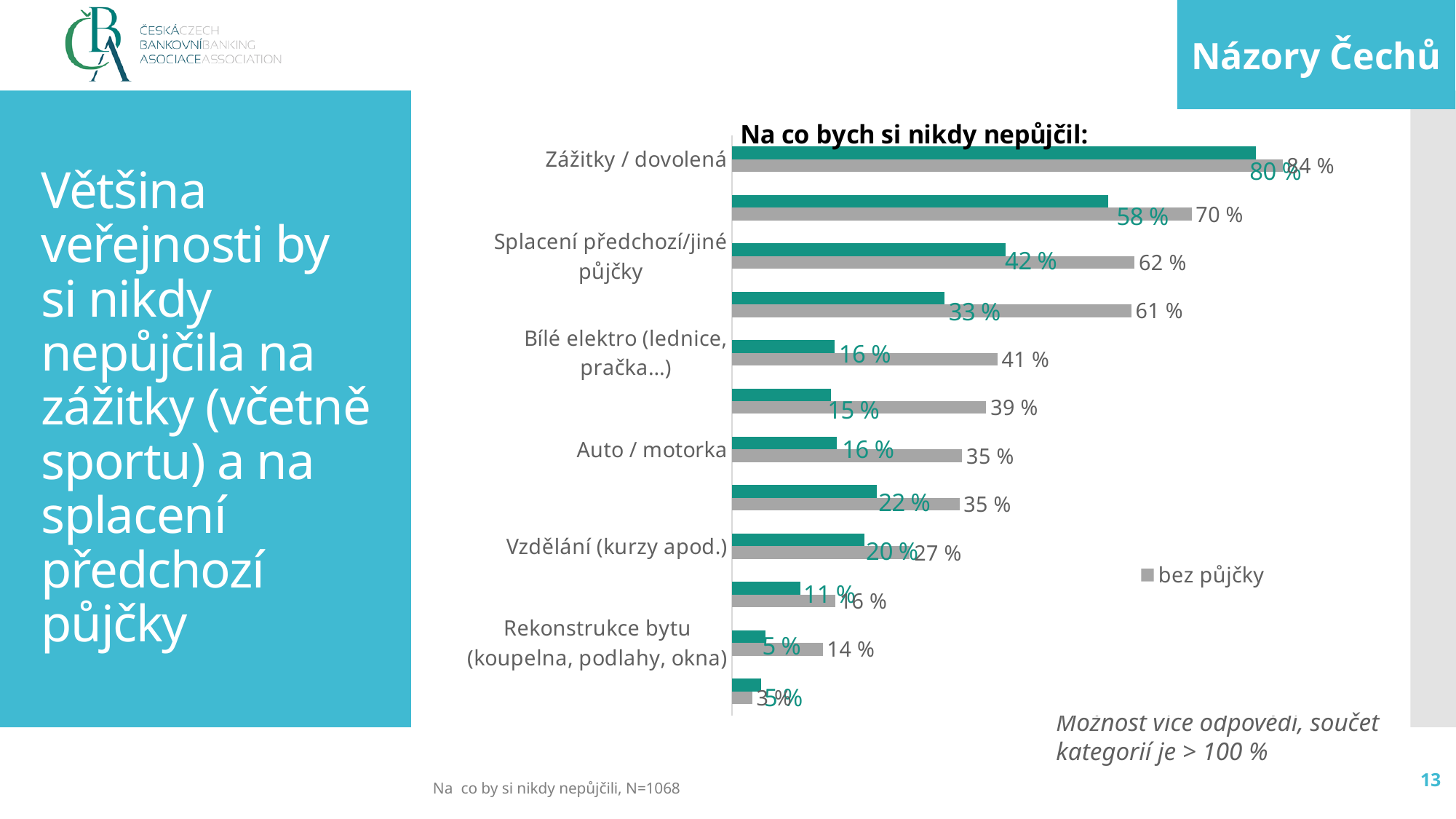
What is the title of the chart? Na co bych si nikdy nepůjčil: What colour are the 'bez půjčky' bars? Gray What is the 'bez půjčky' value for Bílé elektro (lednice, pračka…)? 41 % What kind of chart is shown on the slide? Bar chart Which labelled category has the highest 'bez půjčky' value? Zážitky / dovolená What is the 'bez půjčky' value for Splacení předchozí/jiné půjčky? 62 % What is the 'bez půjčky' value for Rekonstrukce bytu (koupelna, podlahy, okna)? 14 % Which has the larger 'bez půjčky' value: Bílé elektro (lednice, pračka…) or Auto / motorka? Bílé elektro (lednice, pračka…) What value does the teal bar show for Vzdělání (kurzy apod.)? 20 % What is the 'bez půjčky' value for Zážitky / dovolená? 84 % What is the difference between the 'bez půjčky' value and the teal bar value for Splacení předchozí/jiné půjčky? 20 percentage points What value does the teal bar show for Auto / motorka? 16 %